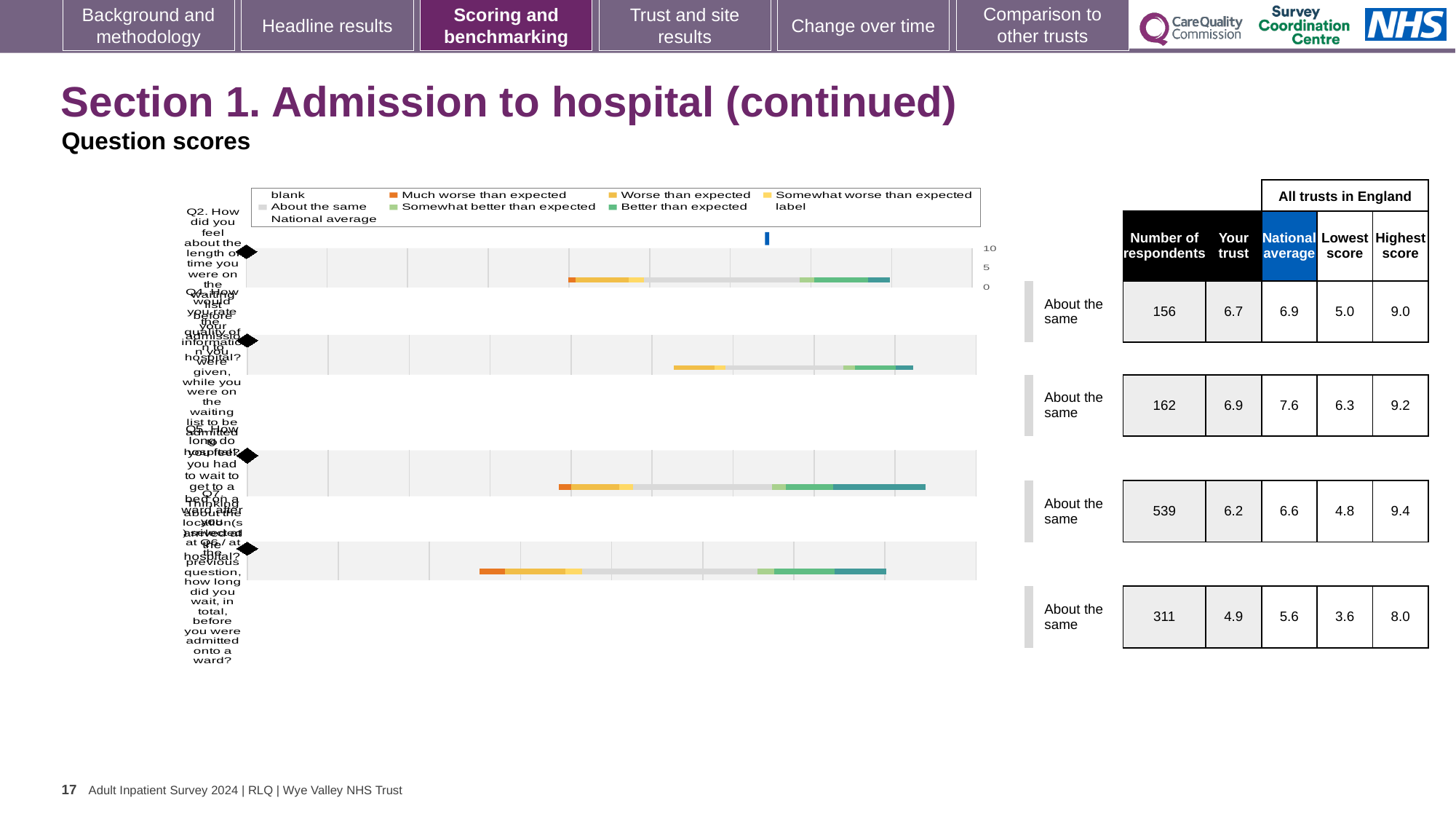
For the first row (156 respondents), which is larger: the 'Your trust' score or the national average? national average What kind of chart is shown on the slide? bar chart What benchmark label is shown next to each of the four question rows? About the same In the table, what is the 'Your trust' score for the first row (156 respondents)? 6.7 In the table, what is the lowest score for the fourth row (311 respondents)? 3.6 For the fourth row (311 respondents), what is the difference between the national average and the 'Your trust' score? 0.7 What is the maximum value shown on the chart's score axis? 10 Which row has the highest 'Your trust' score in the table? the second row (162 respondents), 6.9 In the table, what is the highest score for the third row (539 respondents)? 9.4 In the table, what is the national average for the second row (162 respondents)? 7.6 Which row has the lowest 'Your trust' score in the table? the fourth row (311 respondents), 4.9 How many question rows (diamond markers) are plotted in the chart? 4